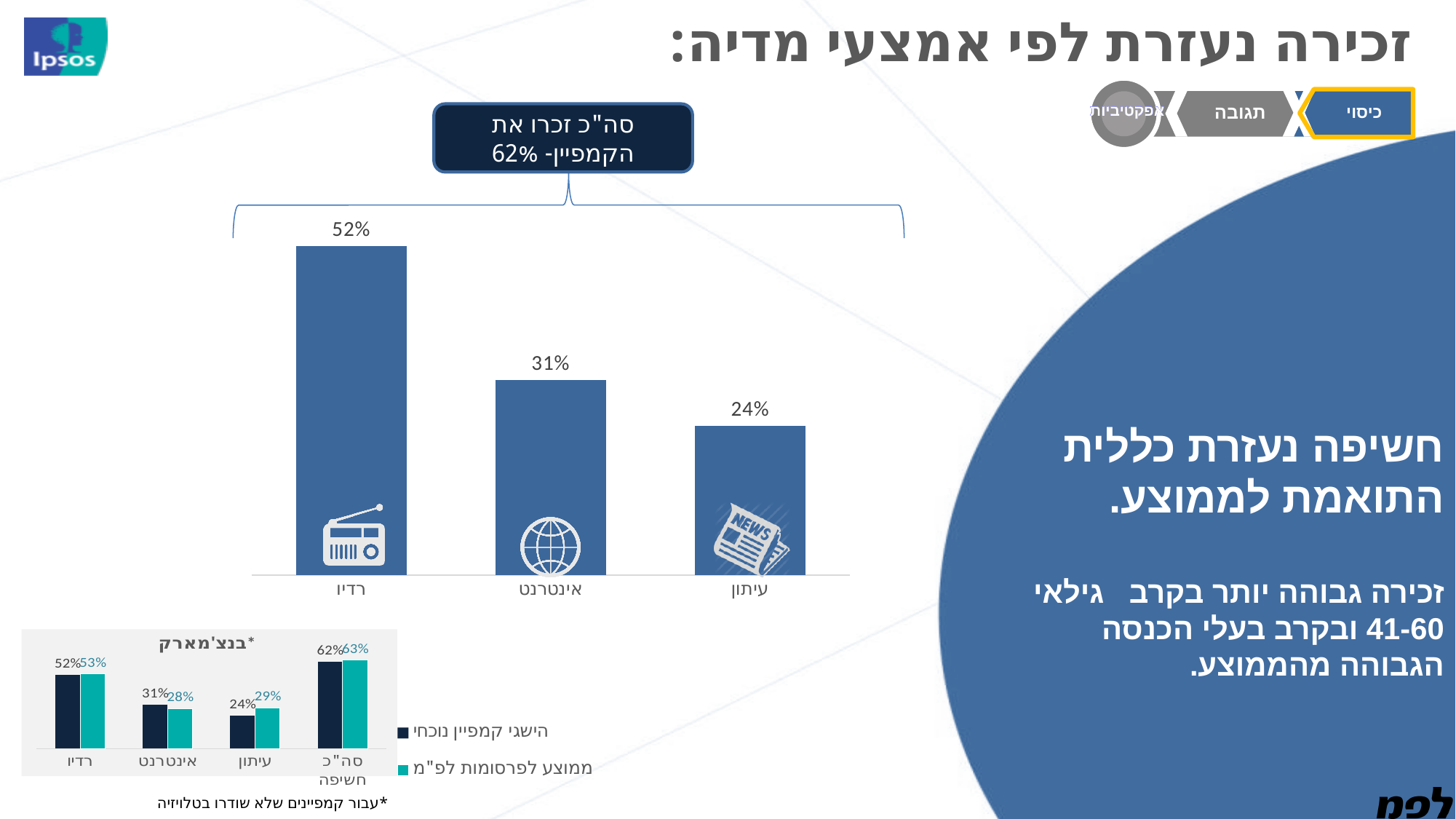
What type of chart is the main chart on the slide? bar chart In the main bar chart, what is the difference between the values for רדיו and עיתון? 28% In the small benchmark chart (בנצ'מארק) at the bottom left, how many series does the legend list? 2 In the main bar chart, what is the value for רדיו (radio)? 52% In the main bar chart, do the values rise or fall from left to right? fall In the main bar chart, what is the value for אינטרנט (internet)? 31% In the main bar chart, which category has the highest value? רדיו In the small benchmark chart (בנצ'מארק), which is larger for עיתון: הישגי קמפיין נוכחי or ממוצע לפרסומות לפ"מ? ממוצע לפרסומות לפ"מ In the small benchmark chart (בנצ'מארק), what is the value of הישגי קמפיין נוכחי for אינטרנט? 31% How many categories are shown in the main bar chart? 3 In the main bar chart, which category has the lowest value? עיתון In the small benchmark chart (בנצ'מארק), what is the value of ממוצע לפרסומות לפ"מ for סה"כ חשיפה? 63%